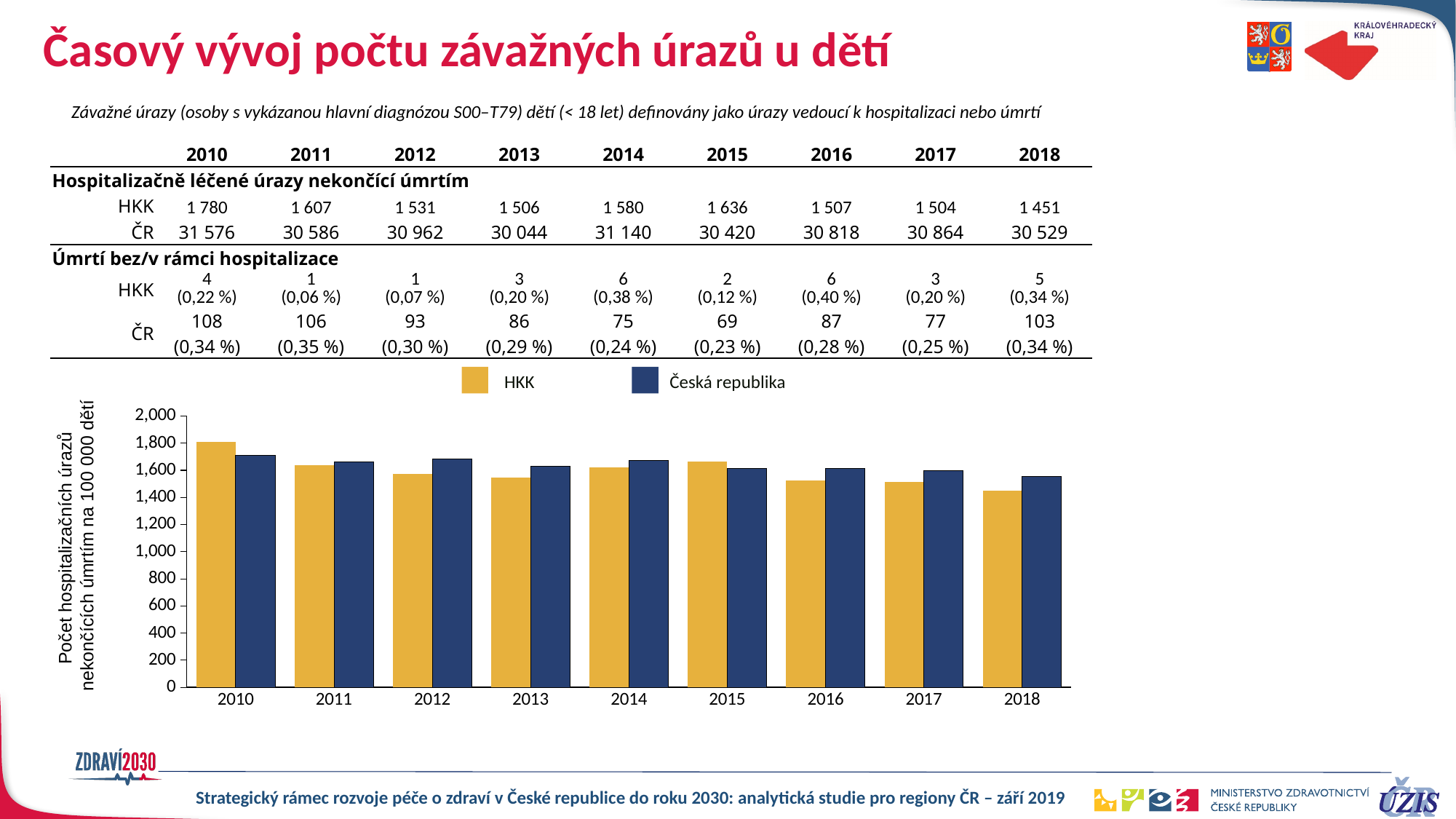
In which year is the HKK bar highest in the chart? 2010 What kind of chart is shown on the slide? bar chart How many series does the chart legend list? 2 In 2010, which bar is taller in the chart, HKK or Česká republika? HKK Is the value for Česká republika in 2012 greater or less than 1,600? greater In which year is the HKK bar lowest in the chart? 2018 Does the HKK series generally rise or fall from 2010 to 2018? fall In 2018, which bar is taller in the chart, HKK or Česká republika? Česká republika Is the value for HKK in 2016 greater or less than 1,600? less How many years are shown on the x axis of the chart? 9 In which year is the Česká republika bar lowest in the chart? 2018 Which series is shown in dark blue in the chart? Česká republika